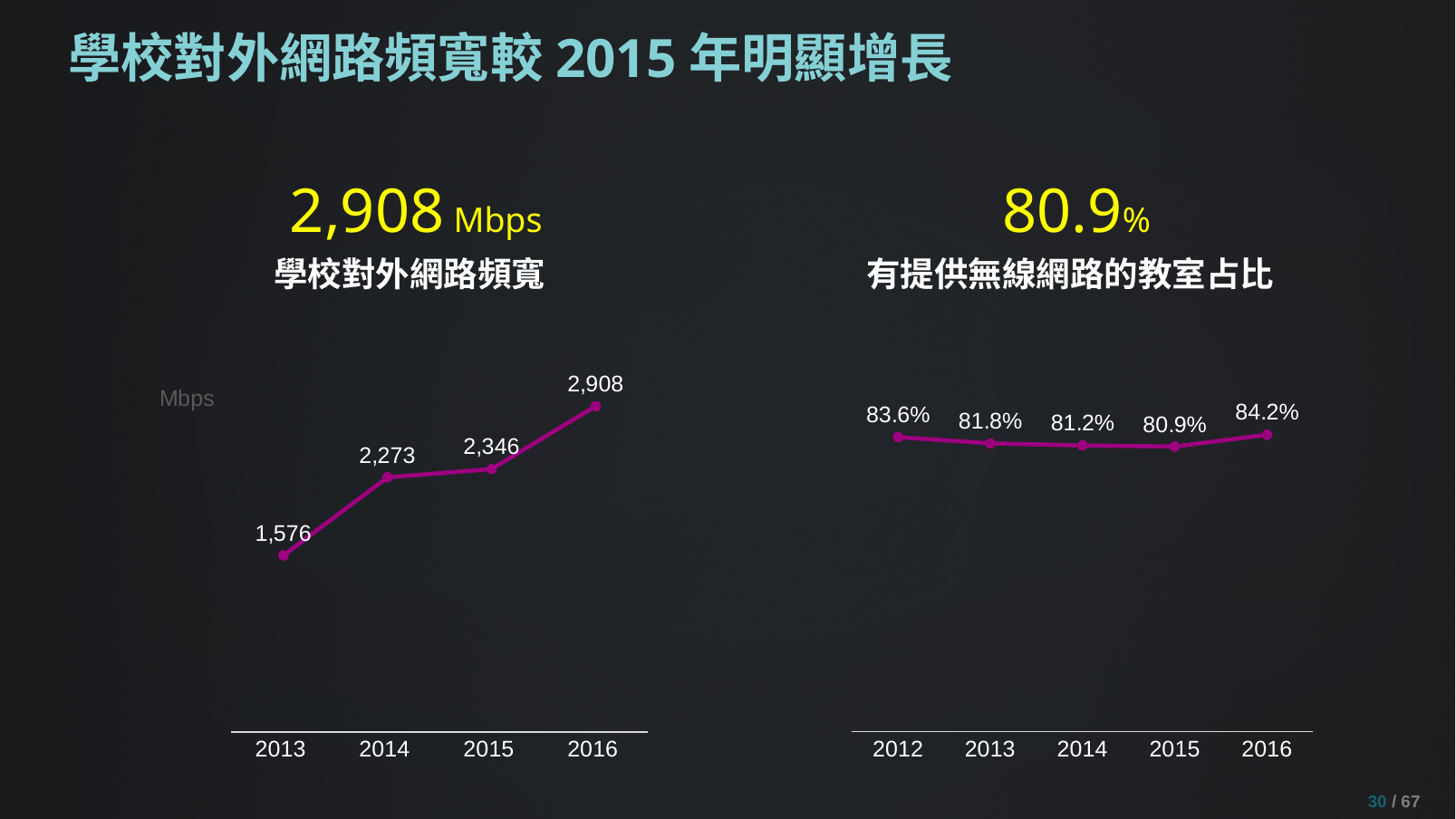
In the right chart (有提供無線網路的教室占比), how many years are plotted? 5 In the left chart (學校對外網路頻寬), do the values rise or fall from 2013 to 2016? rise In the left chart (學校對外網路頻寬), what is the value for 2014? 2,273 In the right chart (有提供無線網路的教室占比), what is the value for 2012? 83.6% In the left chart (學校對外網路頻寬), how many data points are plotted? 4 In the left chart (學校對外網路頻寬), which year has the lowest value? 2013 What type of chart is the left chart (學校對外網路頻寬)? line chart In the right chart (有提供無線網路的教室占比), which year has the lowest value? 2015 In the left chart (學校對外網路頻寬), what is the difference between the 2016 and 2015 values? 562 In the right chart (有提供無線網路的教室占比), which is larger, the value for 2013 or the value for 2014? 2013 In the left chart (學校對外網路頻寬), what is the value for 2016? 2,908 In the right chart (有提供無線網路的教室占比), which year has the highest value? 2016